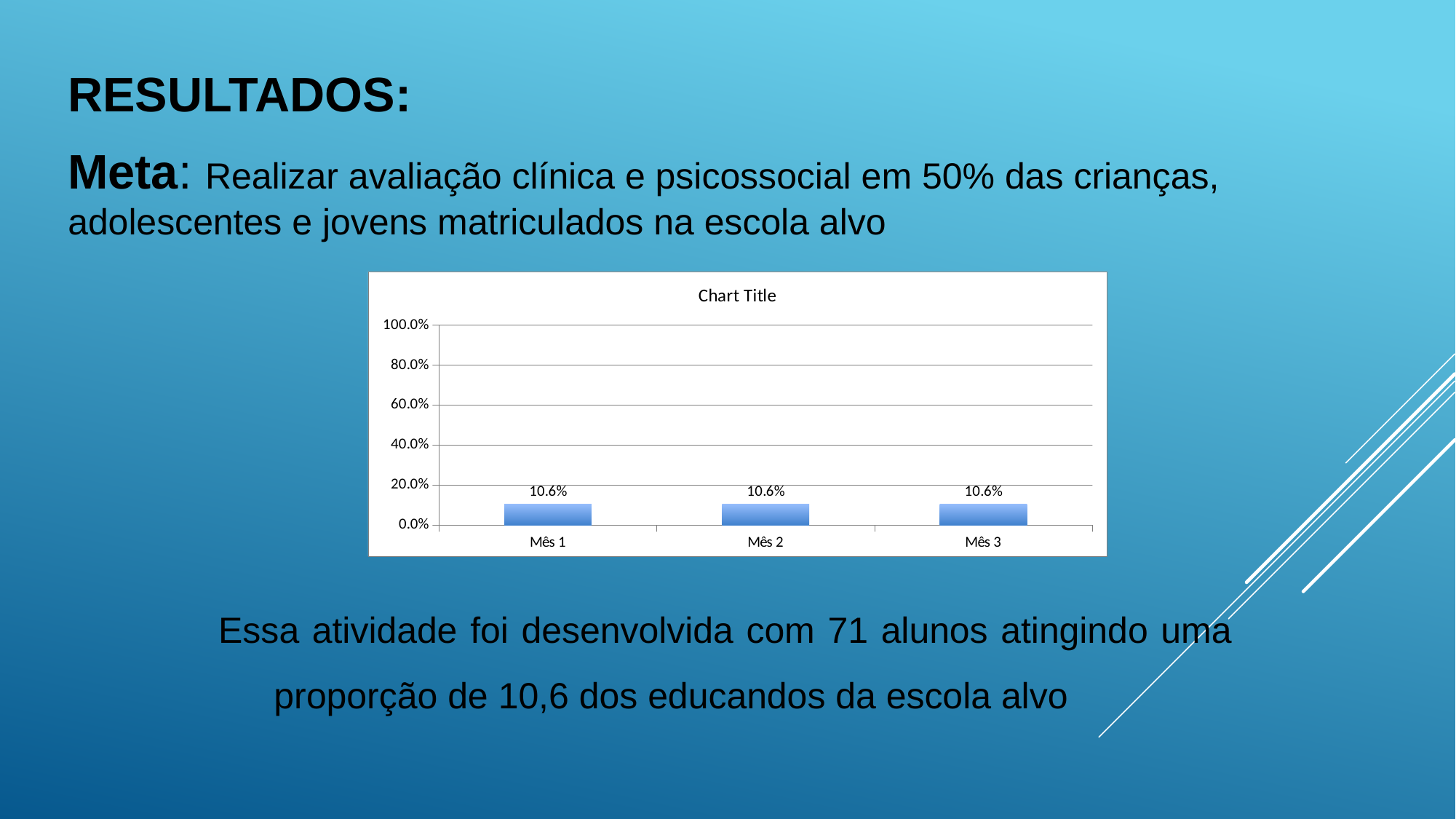
Is the value for Mês 1 greater or less than 40.0%? less What is the value for Mês 1? 10.6% What is the highest value shown on the vertical axis? 100.0% What is the difference between the values for Mês 1 and Mês 3? 0.0% What is the value for Mês 3? 10.6% What kind of chart is shown on the slide? bar chart How many categories are shown on the x axis? 3 Do the values rise, fall or stay the same from Mês 1 to Mês 3? stay the same What is the title shown on the chart? Chart Title What is the value for Mês 2? 10.6% Is the value for Mês 2 greater or less than 20.0%? less